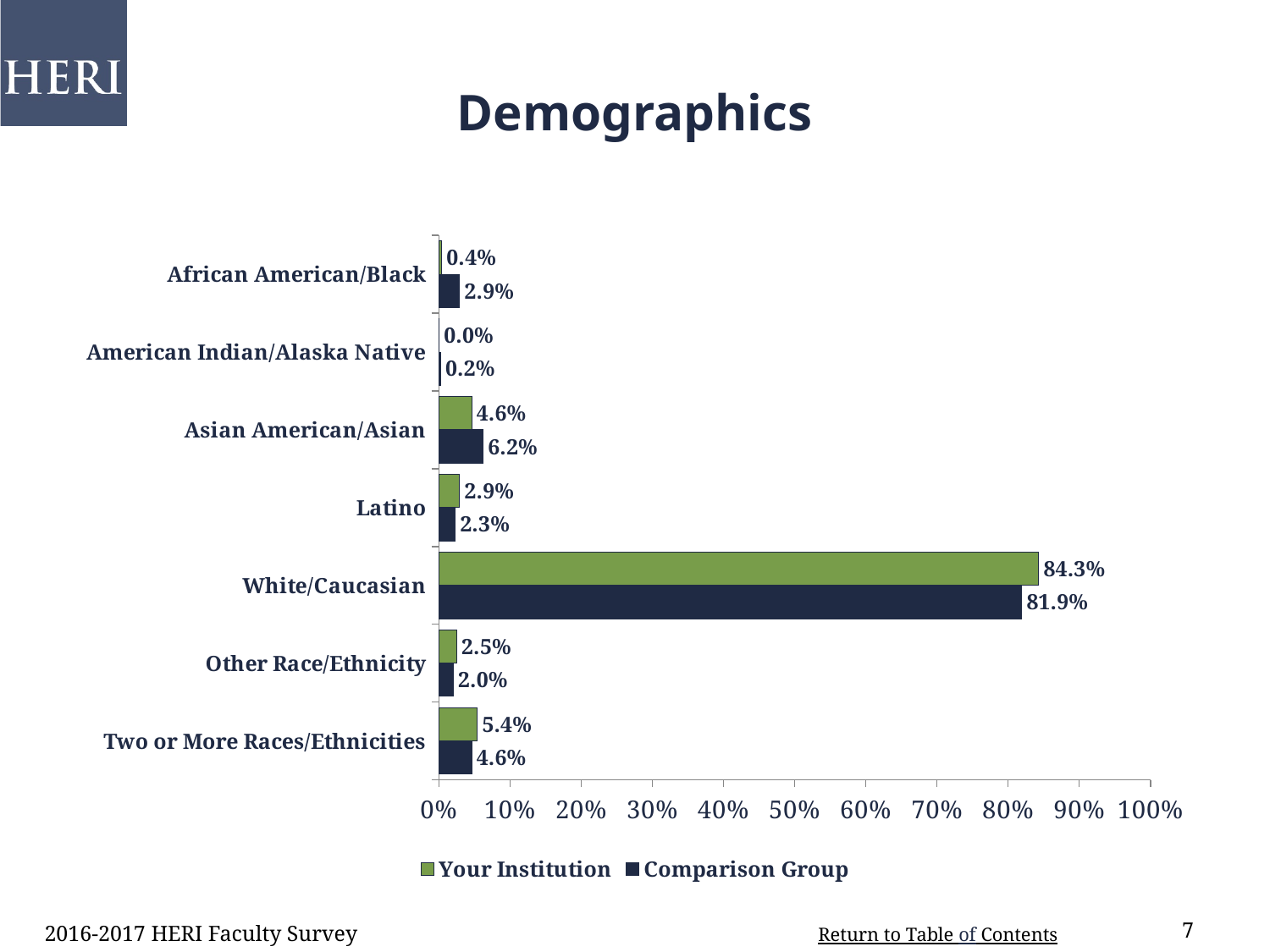
How many categories are shown on the chart? 7 Which category has the highest Your Institution value? White/Caucasian What is the Comparison Group value for White/Caucasian? 81.9% What is the difference between the Your Institution and Comparison Group values for White/Caucasian? 2.4% What is the Your Institution value for Asian American/Asian? 4.6% What is the title of the chart? Demographics What kind of chart is shown on the slide? bar chart What is the Comparison Group value for African American/Black? 2.9% How many series does the legend list? 2 Which category has the lowest Comparison Group value? American Indian/Alaska Native For Two or More Races/Ethnicities, which is larger: Your Institution or Comparison Group? Your Institution Is the Your Institution value for White/Caucasian greater or less than 80%? greater